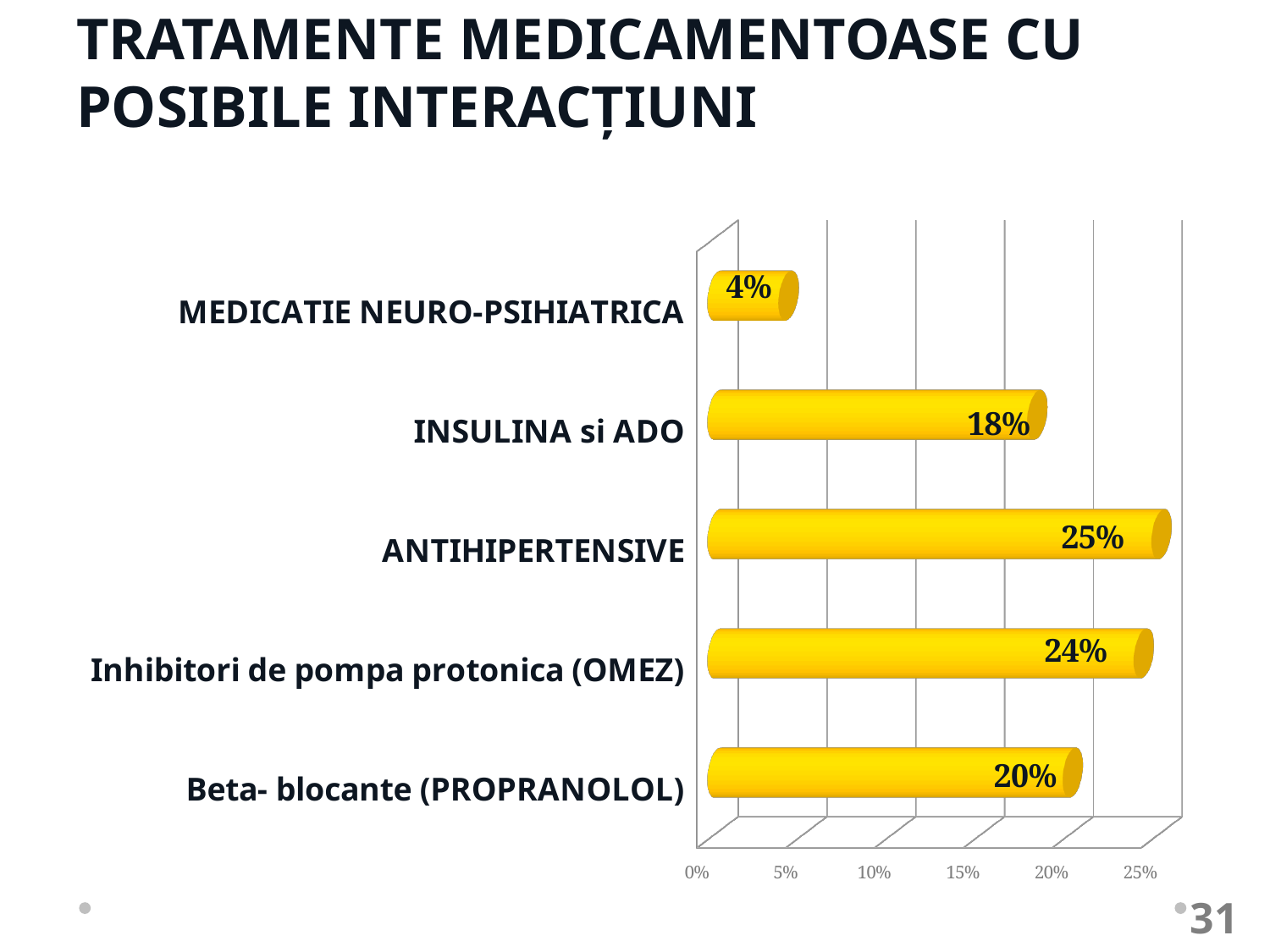
Which category has the highest value? ANTIHIPERTENSIVE Which category has the lowest value? MEDICATIE NEURO-PSIHIATRICA What is the difference between the values for Beta- blocante (PROPRANOLOL) and MEDICATIE NEURO-PSIHIATRICA? 16% Which is larger, the value for Beta- blocante (PROPRANOLOL) or the value for INSULINA si ADO? Beta- blocante (PROPRANOLOL) How many categories are shown in the chart? 5 What is the difference between the values for ANTIHIPERTENSIVE and INSULINA si ADO? 7% What kind of chart is shown on the slide? Bar chart What is the value for Beta- blocante (PROPRANOLOL)? 20% What is the value for Inhibitori de pompa protonica (OMEZ)? 24% What is the value for INSULINA si ADO? 18% What colour are the bars in the chart? Yellow What is the value for MEDICATIE NEURO-PSIHIATRICA? 4%